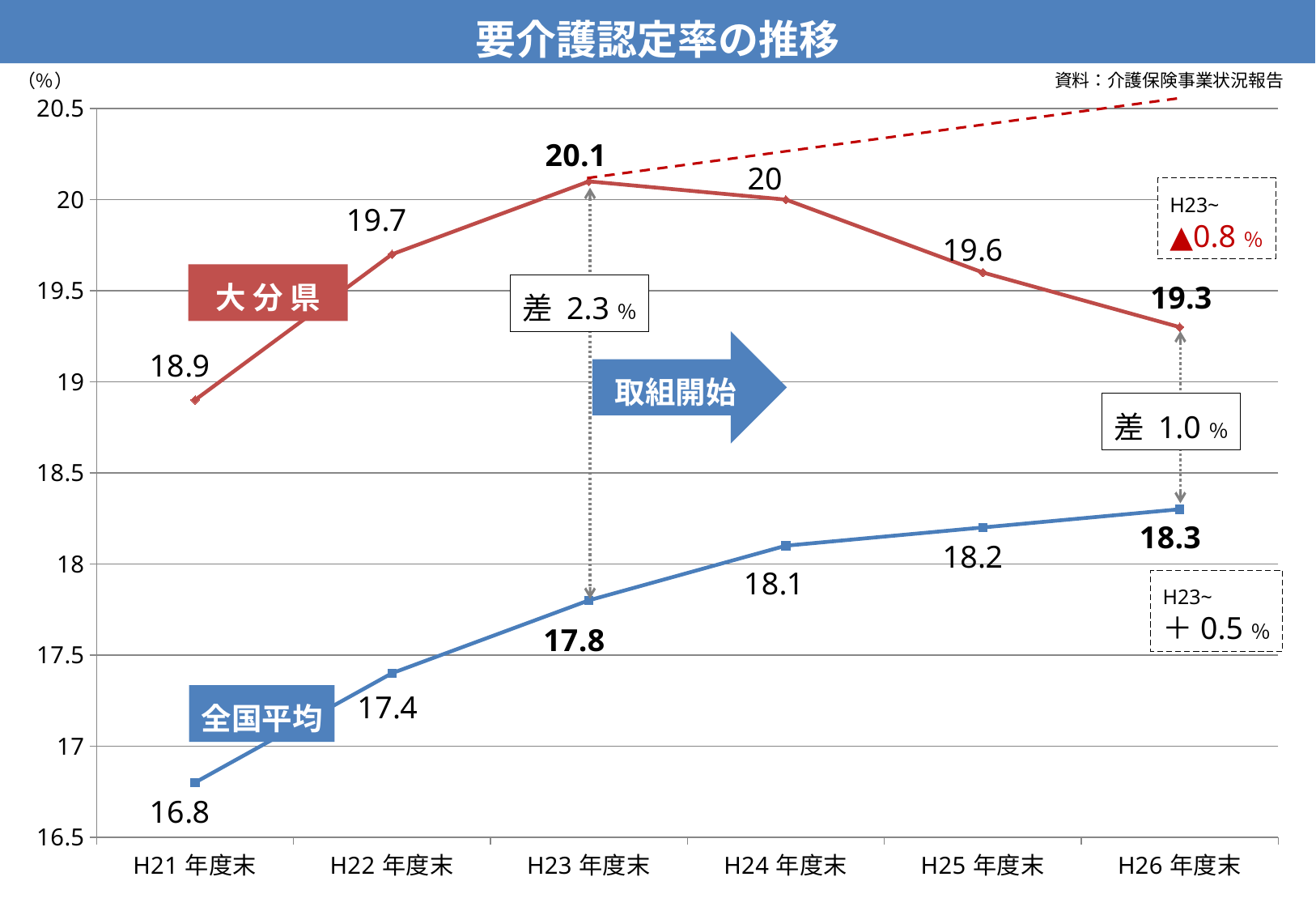
Does the 全国平均 line rise or fall from H21 年度末 to H26 年度末? rise What kind of chart is shown? line chart What is the value for 大分県 at H21 年度末? 18.9 What is the value for 全国平均 at H26 年度末? 18.3 At which year is the 大分県 line at its highest? H23 年度末 What is the value for 大分県 at H23 年度末? 20.1 At which year is the 全国平均 line at its lowest? H21 年度末 How many time points are plotted on the x axis? 6 What is the difference between 大分県 and 全国平均 at H26 年度末? 1.0 Is the value for 大分県 at H25 年度末 greater or less than 19.5? greater Which is larger at H24 年度末, 大分県 or 全国平均? 大分県 How many series are plotted on the chart? 2